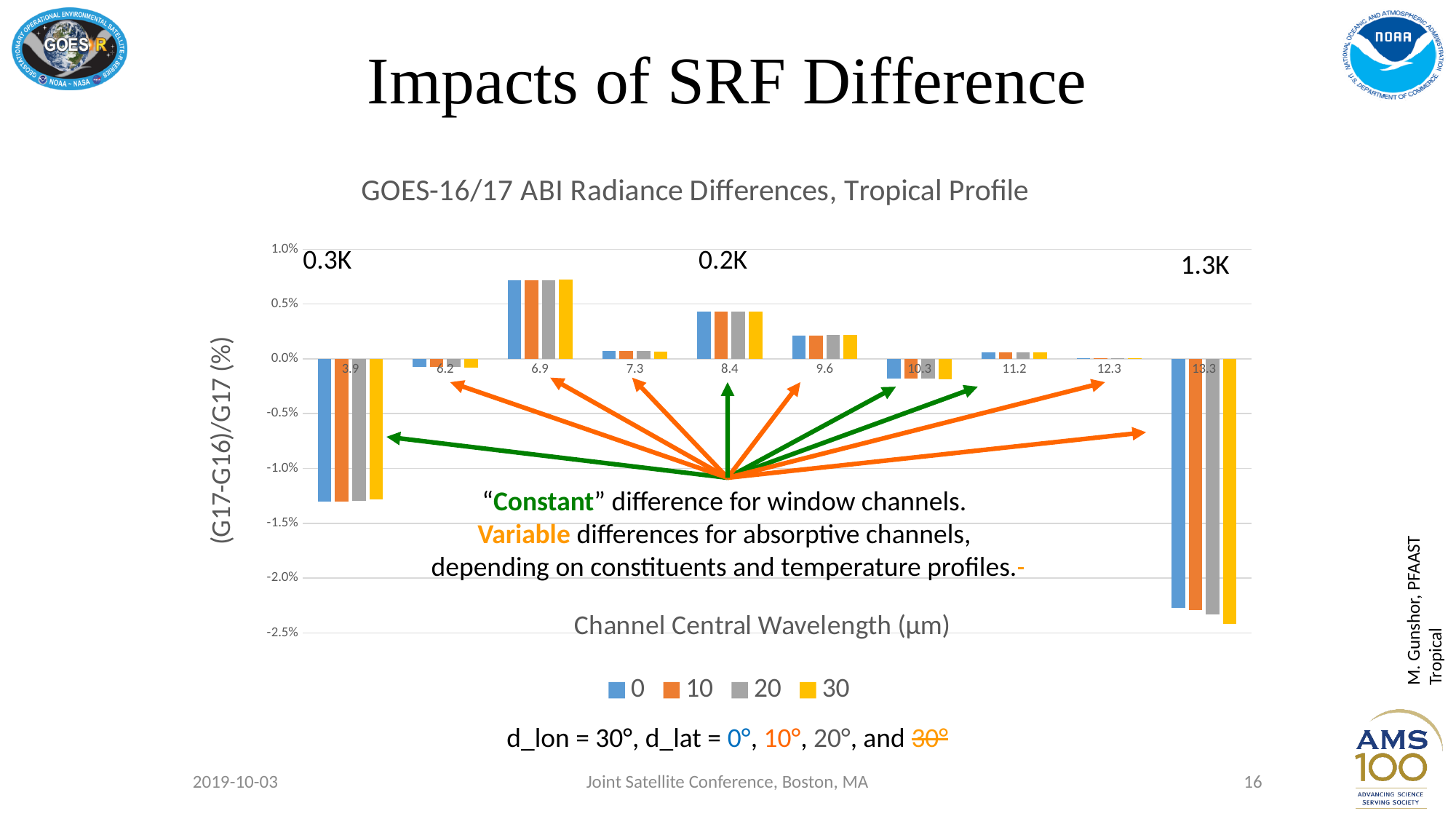
How many series does the chart legend list? 4 Is the value for the 13.3 µm channel (series 0) greater or less than -2.0%? less What is the title of the chart? GOES-16/17 ABI Radiance Differences, Tropical Profile Which channel central wavelength has the lowest (most negative) radiance difference? 13.3 What kind of chart is shown on the slide? bar chart How many channel central wavelength categories are shown on the x axis? 10 Which has the larger radiance difference, the 6.9 µm channel or the 8.4 µm channel? 6.9 Is the value for the 6.9 µm channel (series 0) greater or less than 0.5%? greater Which channel central wavelength has the highest radiance difference? 6.9 Is the value for the 8.4 µm channel (series 0) greater or less than 0.5%? less What is the label of the x axis? Channel Central Wavelength (µm)